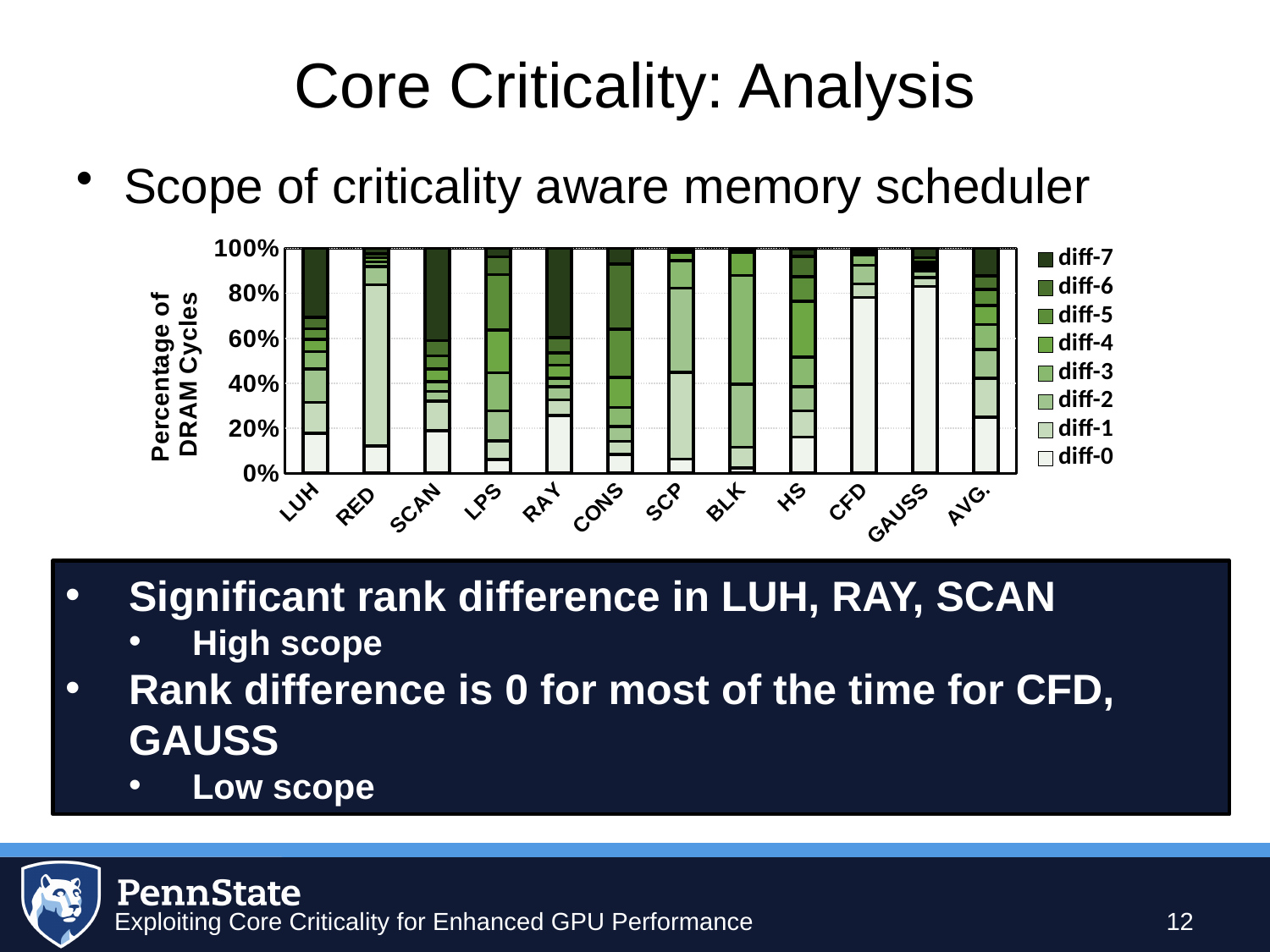
Which category has the smallest diff-0 share? BLK Is the diff-0 share for LUH greater or less than 20%? less What does each stacked bar in the chart total? 100% Is the diff-0 share for BLK greater or less than 20%? less How many categories are shown along the x axis of the chart? 12 What is the label of the y axis of the chart? Percentage of DRAM Cycles Which has a larger diff-0 share, CFD or LUH? CFD How many series does the chart's legend list? 8 Is the diff-0 share for GAUSS greater or less than 60%? greater What kind of chart is shown on the slide? Stacked bar chart Which legend entry appears at the top of the chart's legend? diff-7